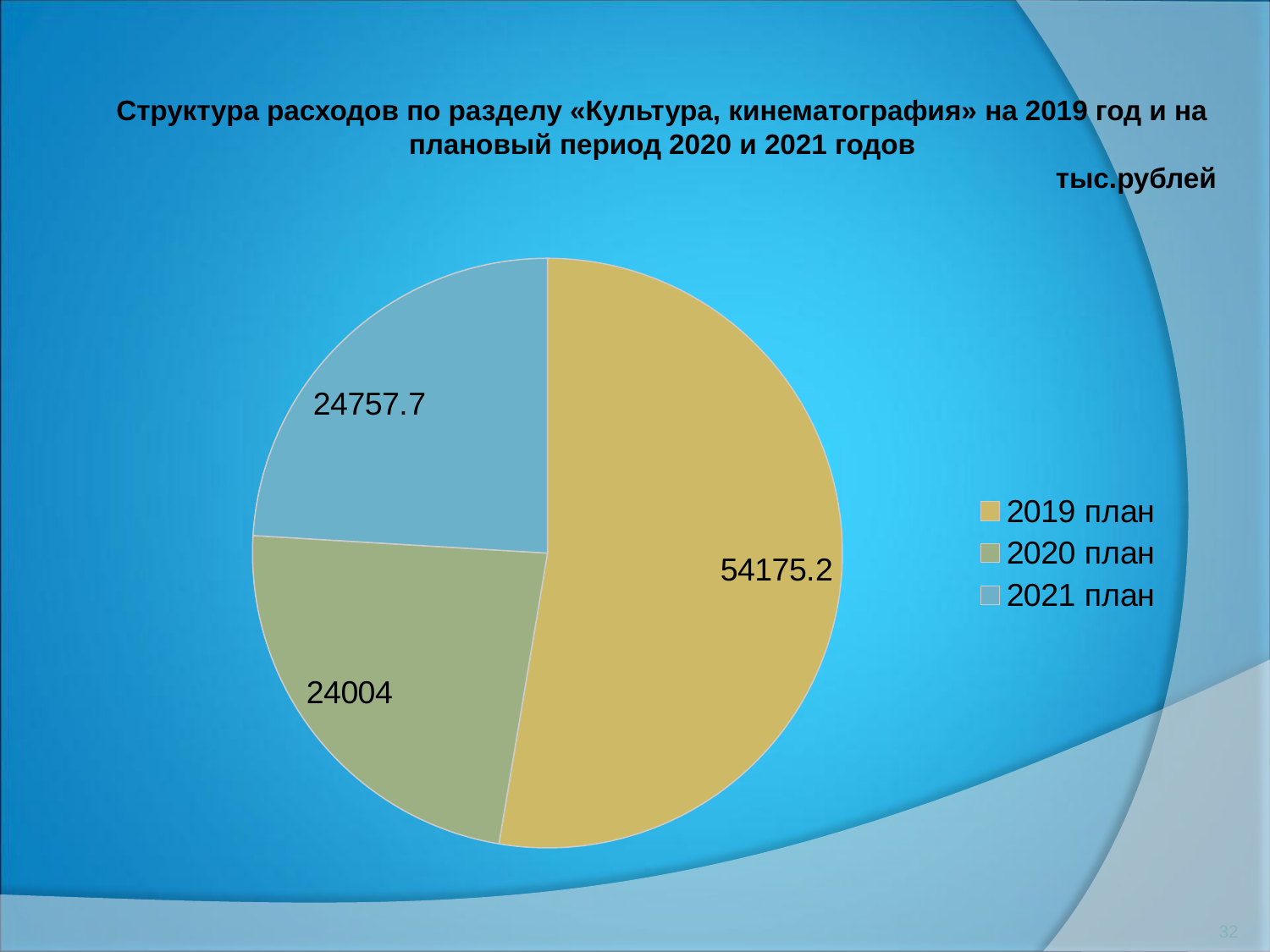
What is the value for 2019 план? 54175.2 What is the value for 2021 план? 24757.7 What is the value for 2020 план? 24004 What kind of chart is shown on the slide? Pie chart Which category has the largest slice of the pie? 2019 план In what units are the values on the chart given? тыс.рублей How many slices does the pie chart have? 3 Which is larger, the value for 2019 план or the value for 2021 план? 2019 план What is the difference between the values for 2019 план and 2020 план? 30171.2 What is the difference between the values for 2021 план and 2020 план? 753.7 Which category has the smallest value? 2020 план